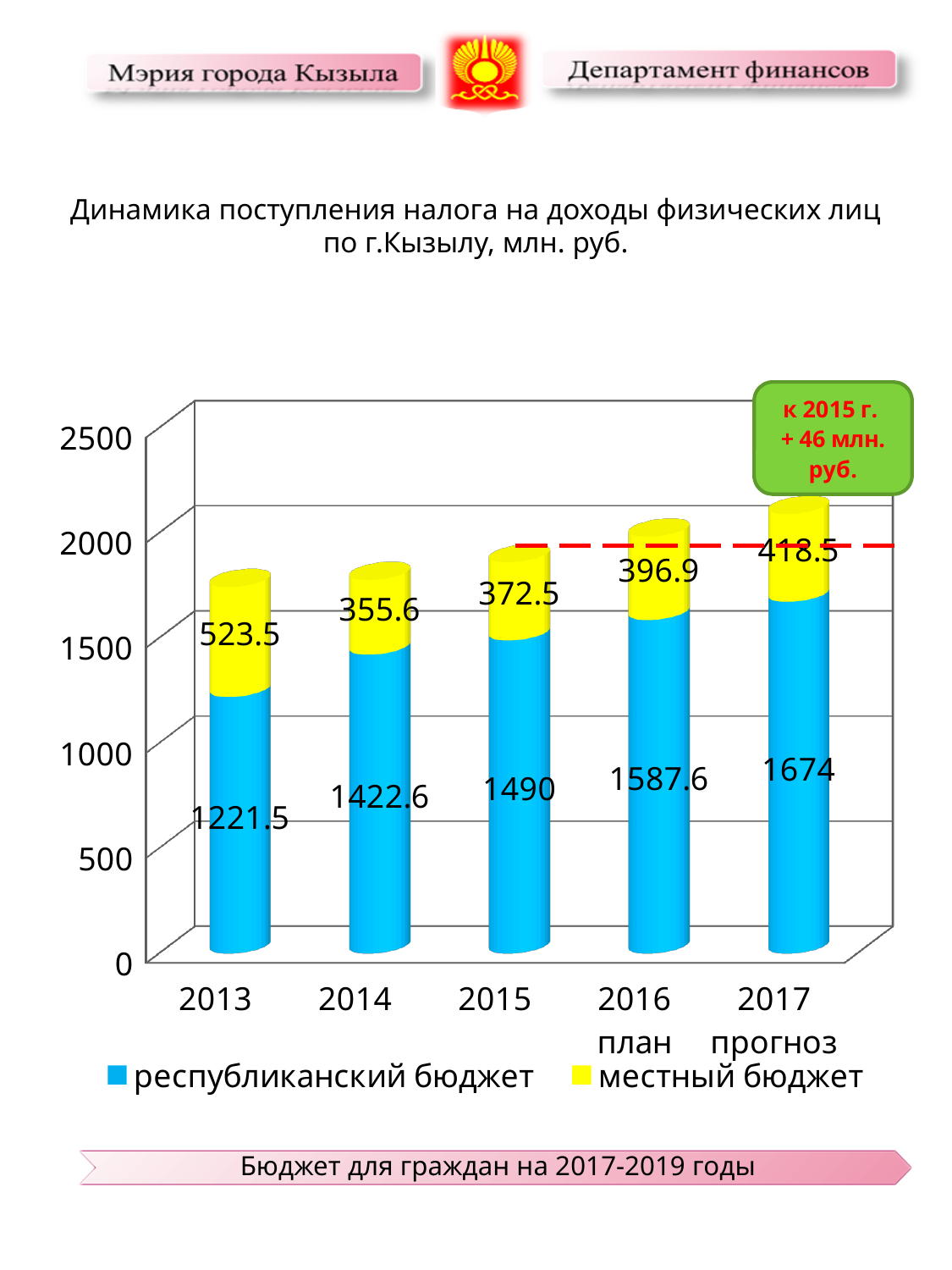
Does the республиканский бюджет series rise or fall from 2013 to 2017? rise What is the value of the местный бюджет series for 2016 план? 396.9 How many years are shown on the x axis? 5 Which year has the lowest value for the республиканский бюджет series? 2013 What is the total of the stacked bar for 2017 прогноз? 2092.5 What is the value of the республиканский бюджет series for 2017 прогноз? 1674 What is the value of the республиканский бюджет series for 2013? 1221.5 Which is larger: the местный бюджет value for 2014 or for 2015? 2015 Which year has the highest value for the местный бюджет series? 2013 How many series does the legend list? 2 What is the difference between the республиканский бюджет values for 2017 прогноз and 2016 план? 86.4 What is the total of the stacked bar for 2015? 1862.5